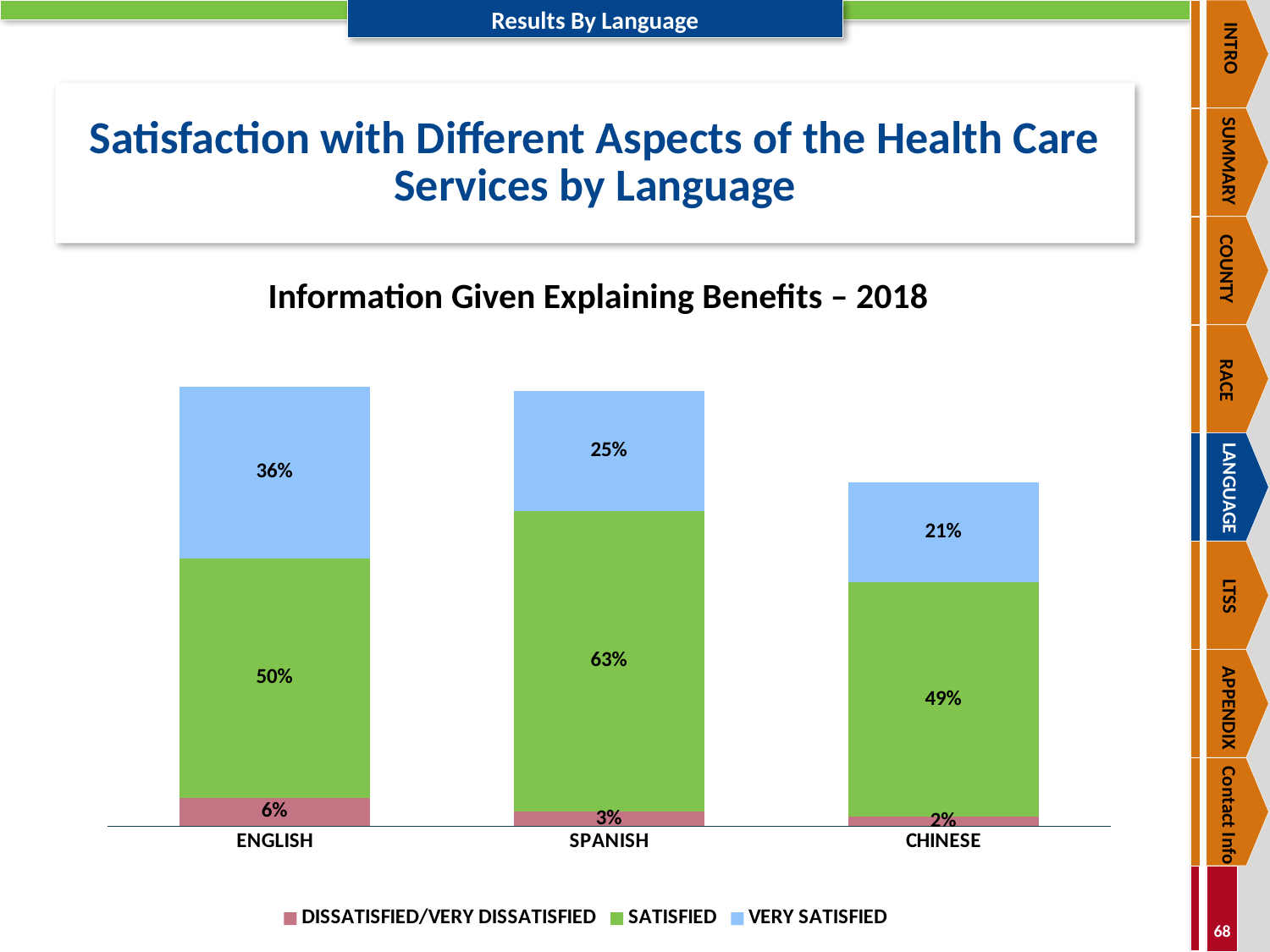
What is the Dissatisfied/Very Dissatisfied value for Chinese? 2% Which language has the highest Satisfied percentage? Spanish What is the Satisfied value for Spanish? 63% How many series does the legend list? 3 What is the total of the stacked bar for Chinese? 72% What percentage of English respondents were Very Satisfied with the information given explaining benefits? 36% How many languages are shown on the x axis? 3 What is the difference between the Very Satisfied values for English and Chinese? 15% What is the title of the chart? Information Given Explaining Benefits – 2018 Which language has the lowest Very Satisfied percentage? Chinese Which is larger: the Dissatisfied/Very Dissatisfied value for English or for Spanish? English What kind of chart is shown on the slide? Stacked bar chart